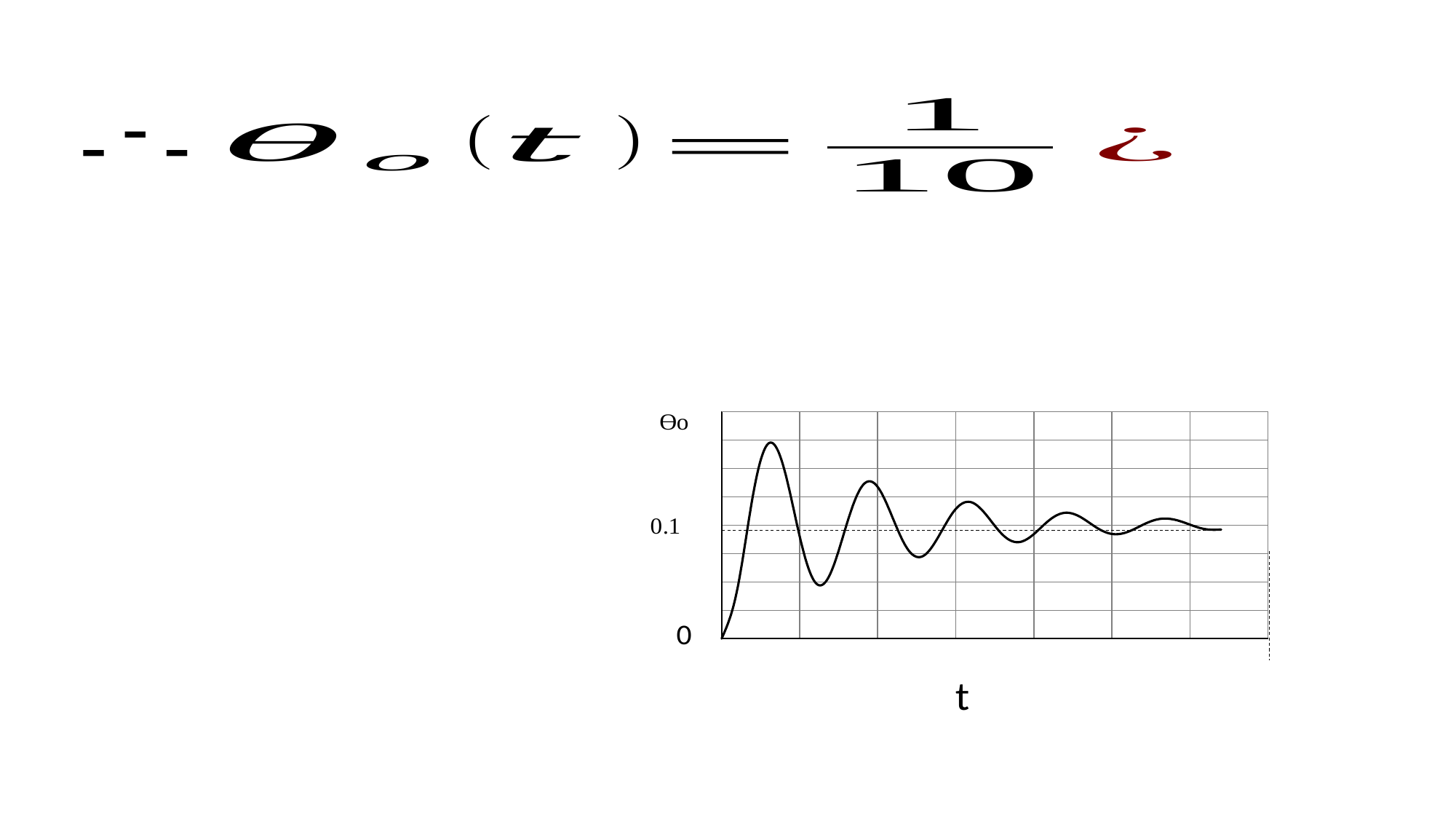
What is the label on the horizontal axis of the chart? t Which is larger, the first peak of the curve or the second peak? the first peak Is the value of the first trough of the curve greater or less than 0.1? less Do the oscillations of the curve grow or shrink as t increases? shrink What is the label on the vertical axis of the chart? Θo What value does the curve settle toward as t increases? 0.1 What value is marked by the dashed horizontal line on the chart? 0.1 What value does the curve start from at t = 0? 0 How many lines are plotted on the chart? 1 What kind of chart is shown on the slide? line chart Is the value of the first peak of the curve greater or less than 0.1? greater